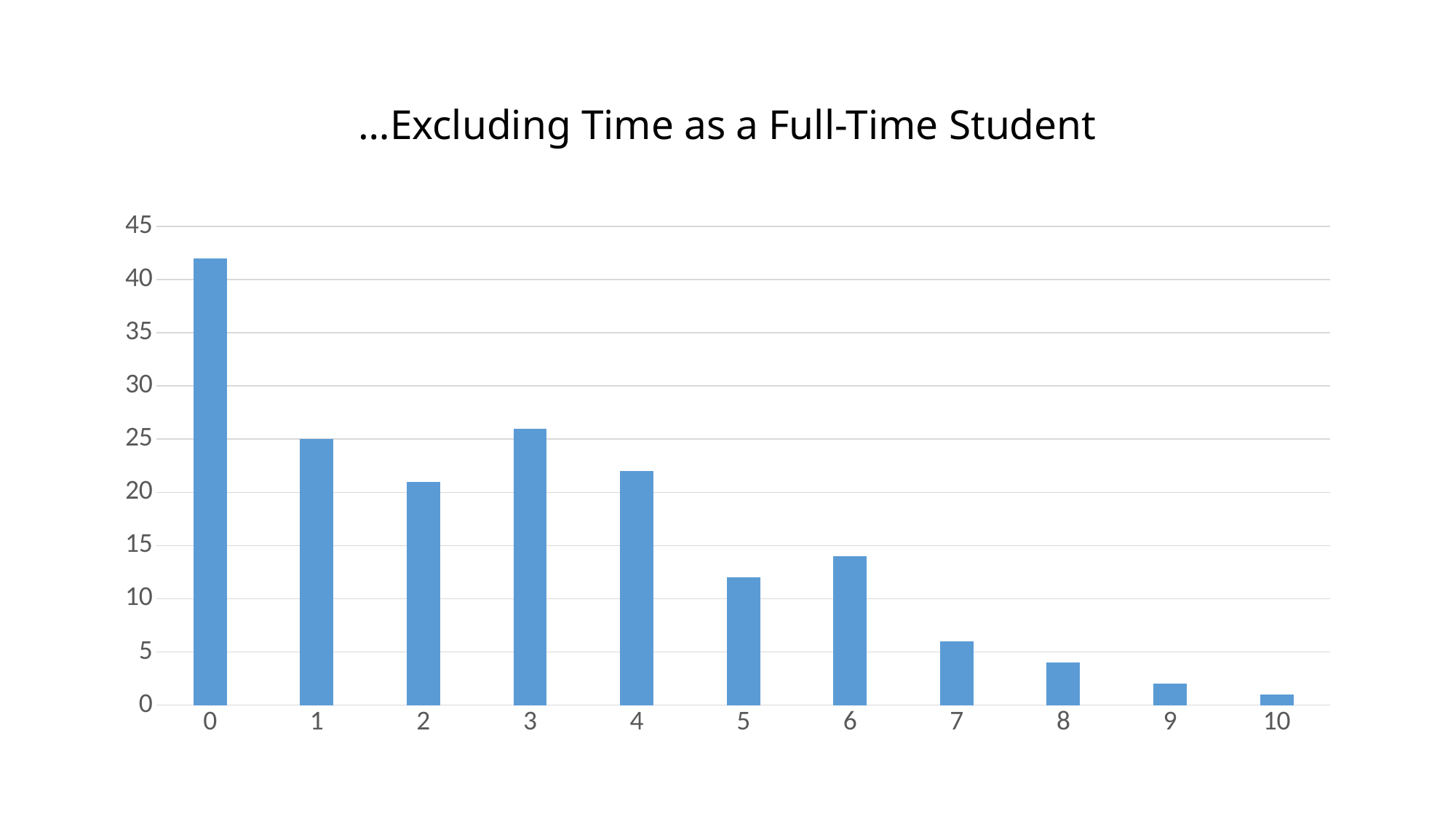
Is the value for category 2 greater or less than 20? greater How many categories are shown on the x axis? 11 Which has the larger value, category 0 or category 3? 0 Is the value for category 0 greater or less than 40? greater Is the value for category 3 greater or less than 25? greater Which category has the highest bar? 0 What is the title of the chart? ...Excluding Time as a Full-Time Student What kind of chart is shown on the slide? bar chart Which category has the lowest bar? 10 Do the values generally rise or fall as the x axis goes from 0 to 10? fall